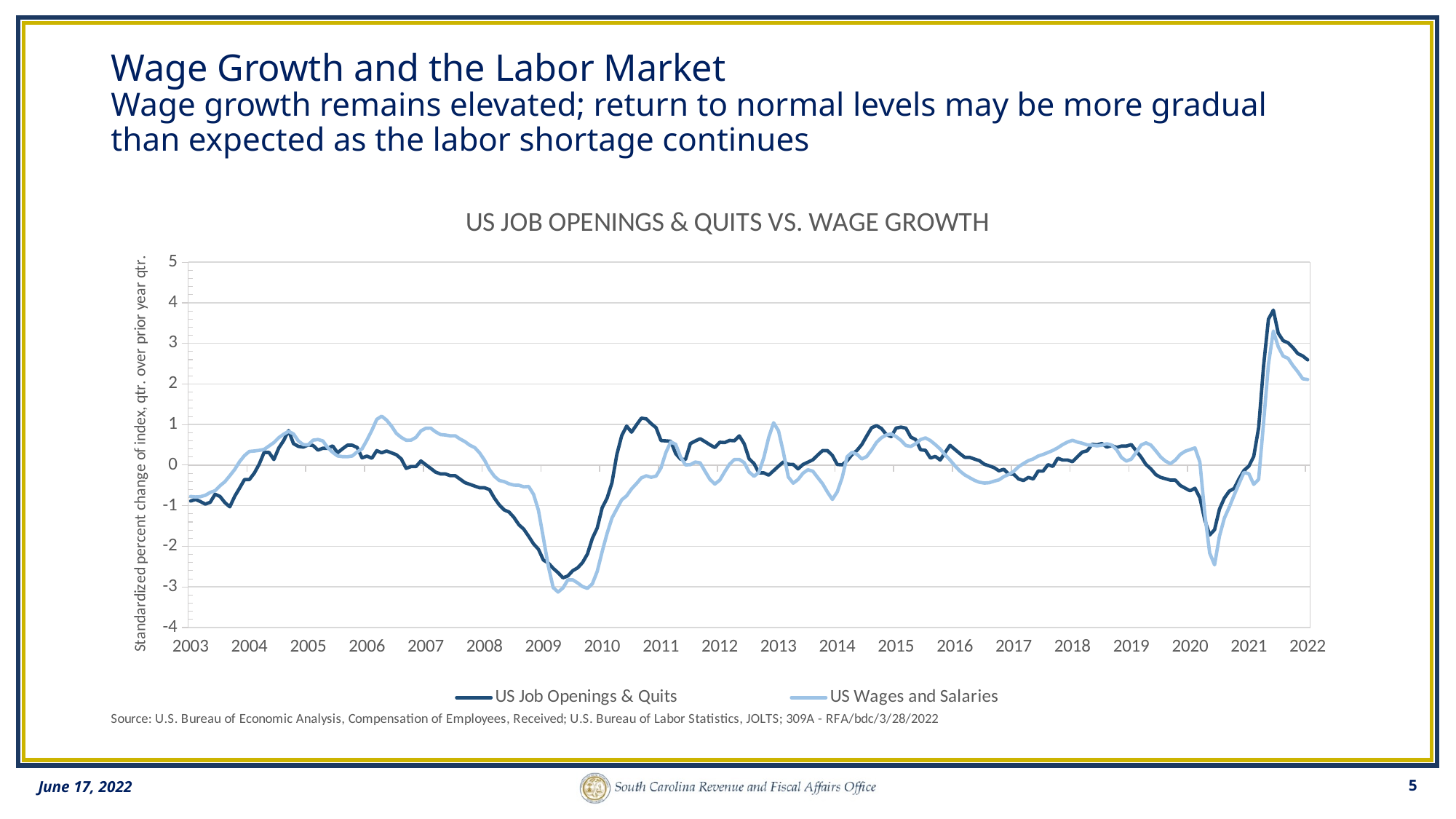
What are the two series named in the legend? US Job Openings & Quits; US Wages and Salaries Is the peak value of US Wages and Salaries in 2021 greater or less than 2? greater How many year labels are shown on the x axis? 20 From its 2021 peak to 2022, does the US Job Openings & Quits line rise or fall? fall Which series drops to a lower value in 2020, US Job Openings & Quits or US Wages and Salaries? US Wages and Salaries Is the lowest value of US Wages and Salaries around 2009 greater or less than -2? less Is the peak value of US Job Openings & Quits in 2021 greater or less than 3? greater What kind of chart is shown on the slide? line chart What is the title of the chart? US JOB OPENINGS & QUITS VS. WAGE GROWTH Which series reaches a higher peak in 2021, US Job Openings & Quits or US Wages and Salaries? US Job Openings & Quits How many series does the legend list? 2